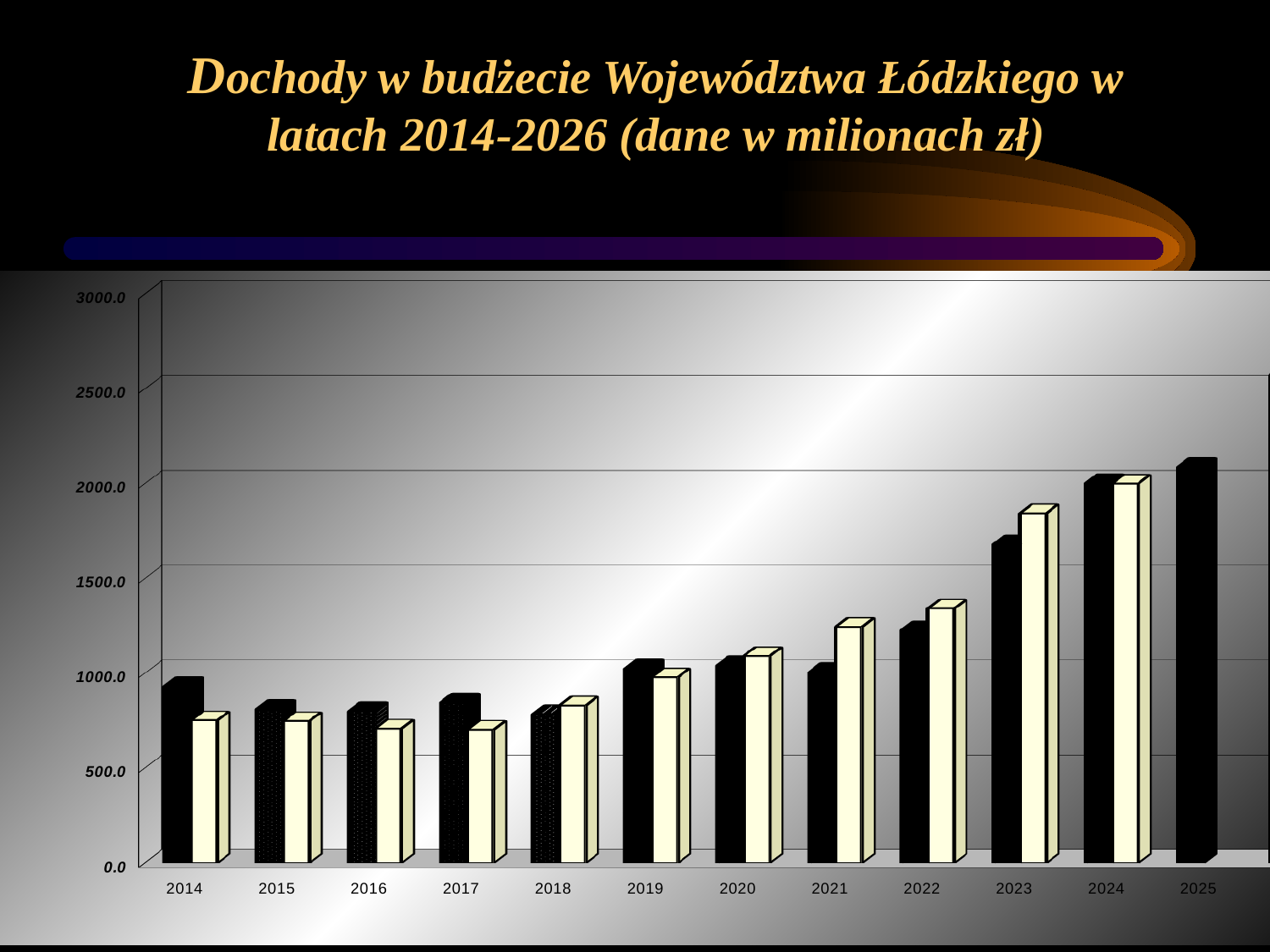
Is the value of the light-coloured bar for 2023 greater or less than 2000? less For 2014, which bar is taller, the black bar or the light-coloured bar? the black bar How many years are shown on the x axis of the chart? 12 What is the highest value shown on the vertical axis of the chart? 3000.0 Is the value of the black bar for 2023 greater or less than 1500? greater Which year has the tallest light-coloured bar? 2024 Do the black bars rise or fall from 2021 to 2025? rise For 2023, which bar is taller, the black bar or the light-coloured bar? the light-coloured bar Is the value of the black bar for 2025 greater or less than 2000? greater Which year has the tallest black bar? 2025 What kind of chart is shown on the slide? bar chart